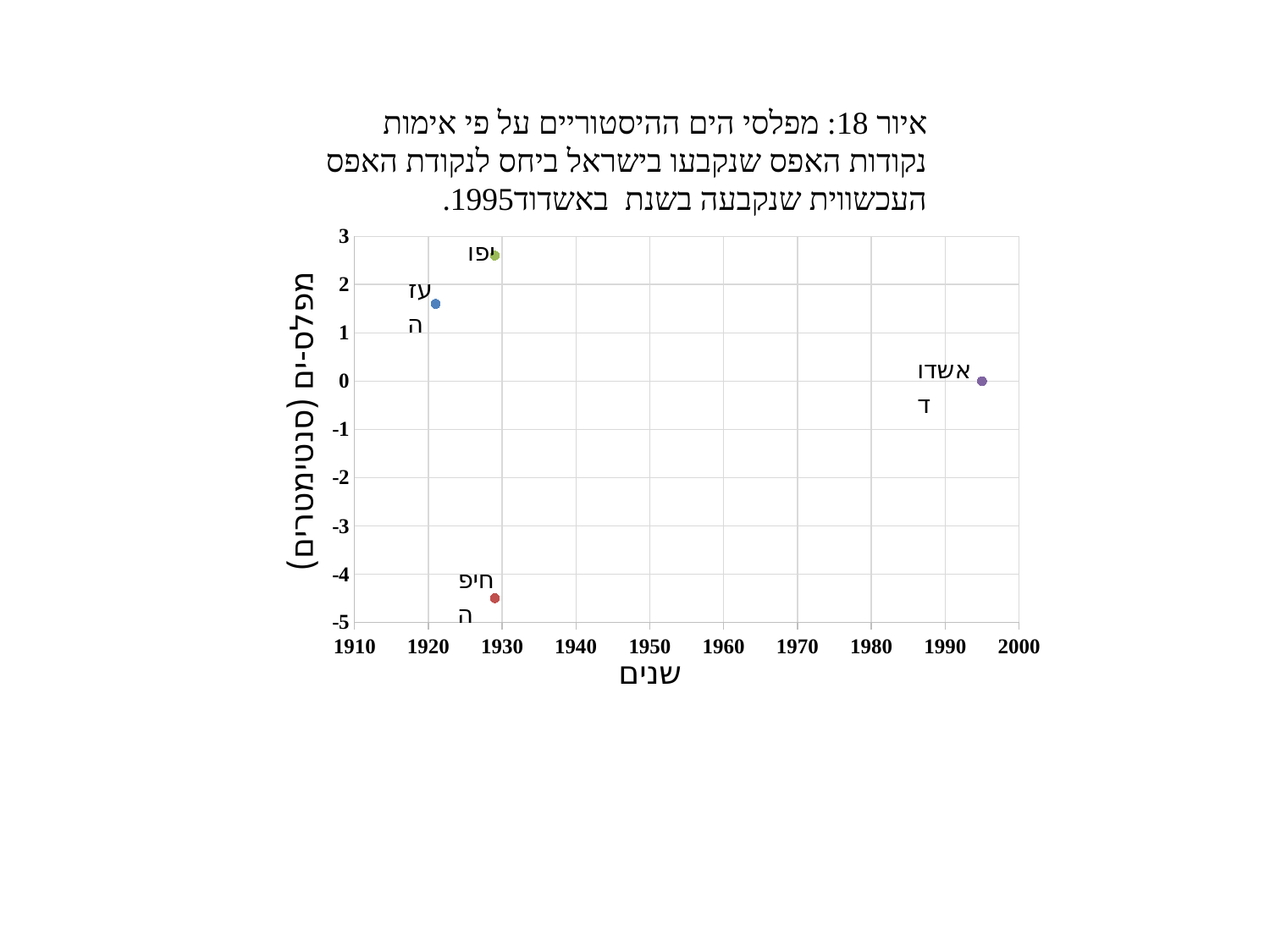
What is the title of the x axis? שנים Which labelled point has the highest sea-level value? יפו How many data points are plotted on the chart? 4 Which has a larger sea-level value, אשדוד or חיפה? אשדוד Is the value for עזה greater or less than 1? greater Which has a larger sea-level value, יפו or עזה? יפו What kind of chart is shown on the slide? scatter chart Is the value for יפו greater or less than 2? greater Is the value for חיפה greater or less than -4? less Which labelled point has the lowest sea-level value? חיפה What is the title of the y axis? מפלס-ים (סנטימטרים) What is the sea-level value (in centimetres) for אשדוד? 0